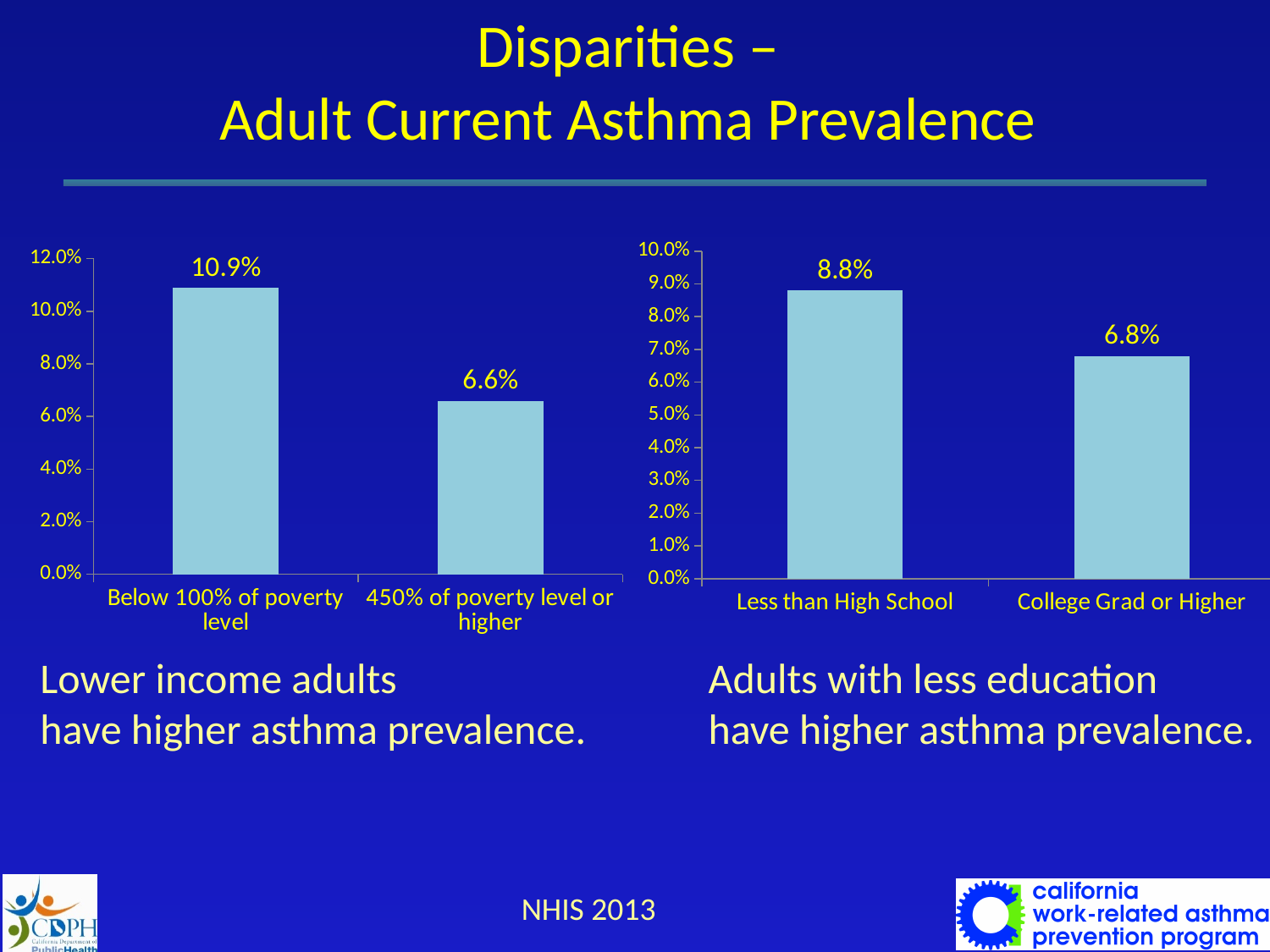
How many categories are shown in the left chart (poverty level)? 2 Is the asthma prevalence for adults with less than high school education (right chart) greater or less than 8.0%? greater What type of chart is used in the right chart (education)? Bar chart In the right chart (education), what is the difference in asthma prevalence between adults with less than high school and college graduates or higher? 2.0% In the left chart (poverty level), what is the asthma prevalence for adults below 100% of poverty level? 10.9% In the left chart (poverty level), which category has the higher asthma prevalence? Below 100% of poverty level In the right chart (education), which category has the lower asthma prevalence? College Grad or Higher In the left chart (poverty level), what is the difference in asthma prevalence between adults below 100% of poverty level and those at 450% or higher? 4.3% In the left chart (poverty level), what is the asthma prevalence for adults at 450% of poverty level or higher? 6.6% In the right chart (education), what is the asthma prevalence for college graduates or higher? 6.8% What is the data source cited at the bottom of the slide? NHIS 2013 In the right chart (education), what is the asthma prevalence for adults with less than high school education? 8.8%